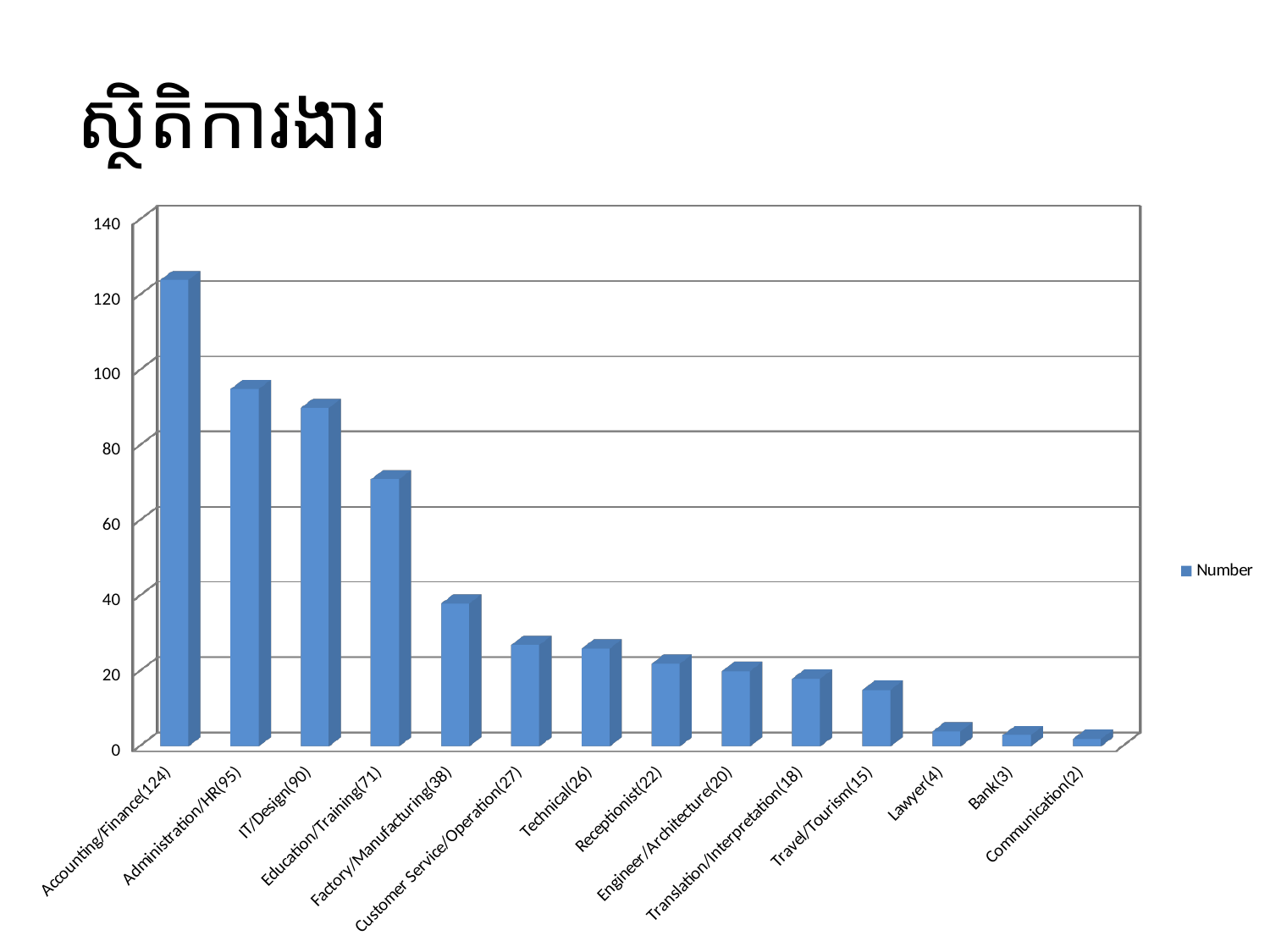
Which category has the lowest value? Communication(2) What is the value for IT/Design according to its category label? 90 Do the values rise or fall from left to right along the x axis? fall What kind of chart is shown on the slide? bar chart Which is larger, the value for Education/Training or the value for Technical? Education/Training Is the value for Administration/HR greater or less than 100? less How many categories are plotted on the chart? 14 Which category has the highest value? Accounting/Finance(124) What is the value for Factory/Manufacturing according to its category label? 38 How many series does the legend list? 1 What is the difference between the values for Accounting/Finance(124) and Administration/HR(95)? 29 What is the name of the series shown in the legend? Number